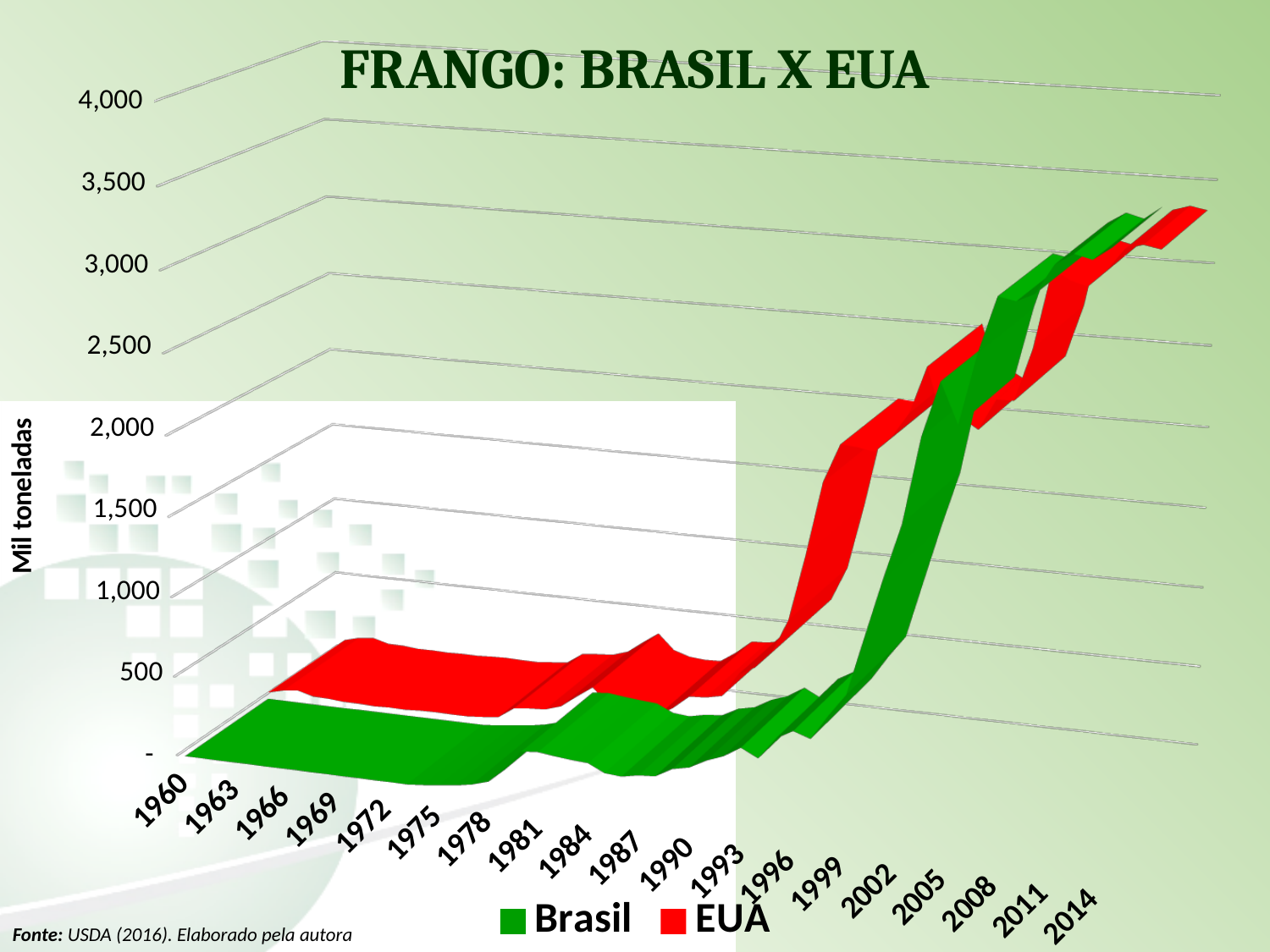
What is the title of the chart? FRANGO: BRASIL X EUA How many year labels are shown on the x axis? 19 What type of chart is shown on the slide? line chart In 1999, which series has the higher value, Brasil or EUA? EUA In 1960, which series has the higher value, Brasil or EUA? EUA Do the values for EUA rise or fall overall from 1960 to 2014? rise Do the values for Brasil rise or fall overall from 1960 to 2014? rise Is the value for EUA in 1975 greater or less than 1,500? less How many series does the legend list? 2 Is the value for Brasil in 2014 greater or less than 2,500? greater Which series is shown in red in the legend? EUA Is the value for Brasil in 1960 greater or less than 500? less